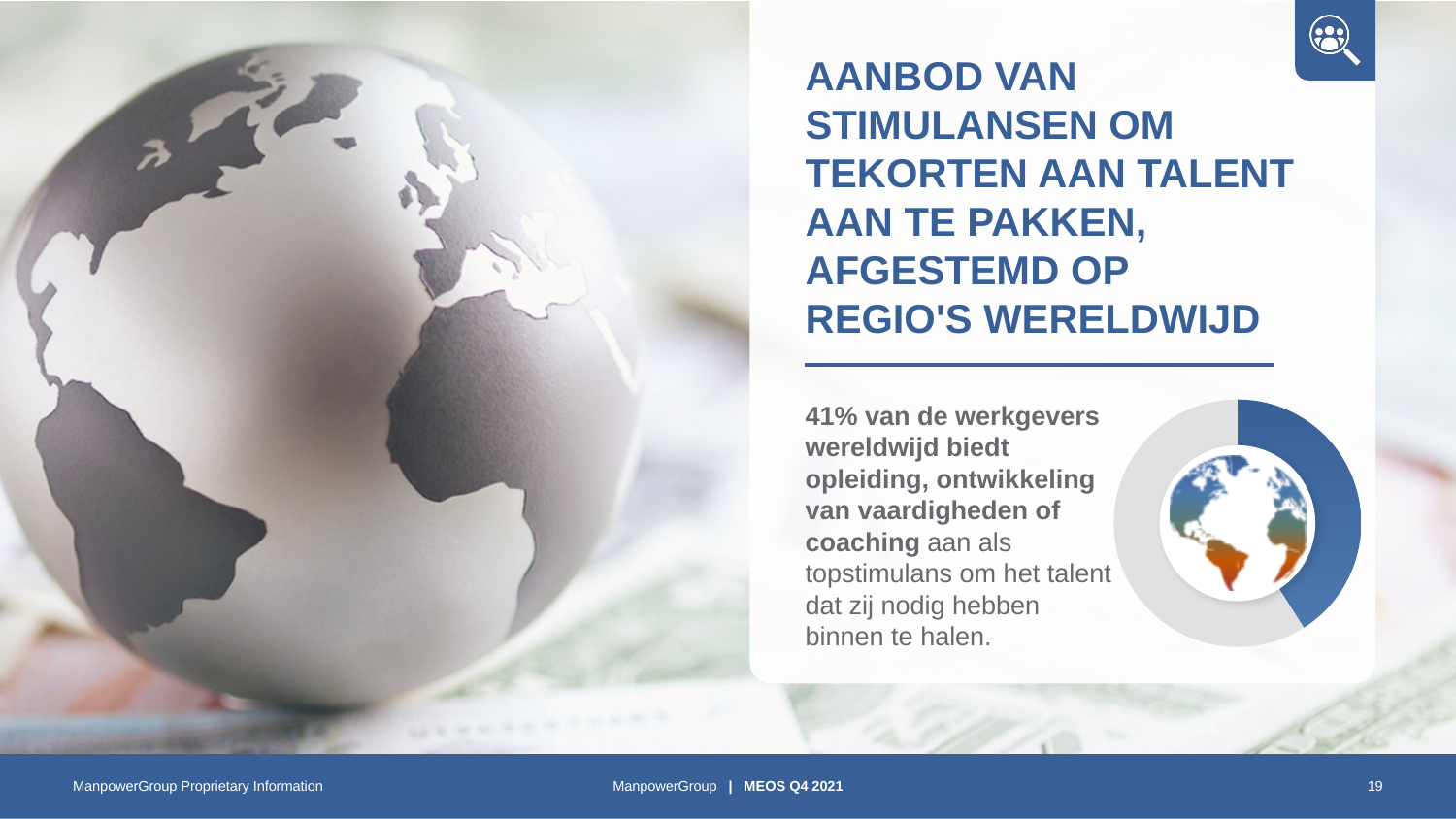
How many segments does the donut chart have? 2 What image is placed in the centre of the donut chart? a globe Which segment of the donut chart is larger, the blue one or the grey one? the grey one Is the blue segment of the donut chart greater or less than 50% of the ring? less What colour is the segment of the donut chart that represents the 41% of employers offering training, skills development or coaching? blue According to the slide text, what share of employers worldwide does the blue segment of the donut chart represent? 41% What kind of chart is shown on the right side of the slide? donut chart